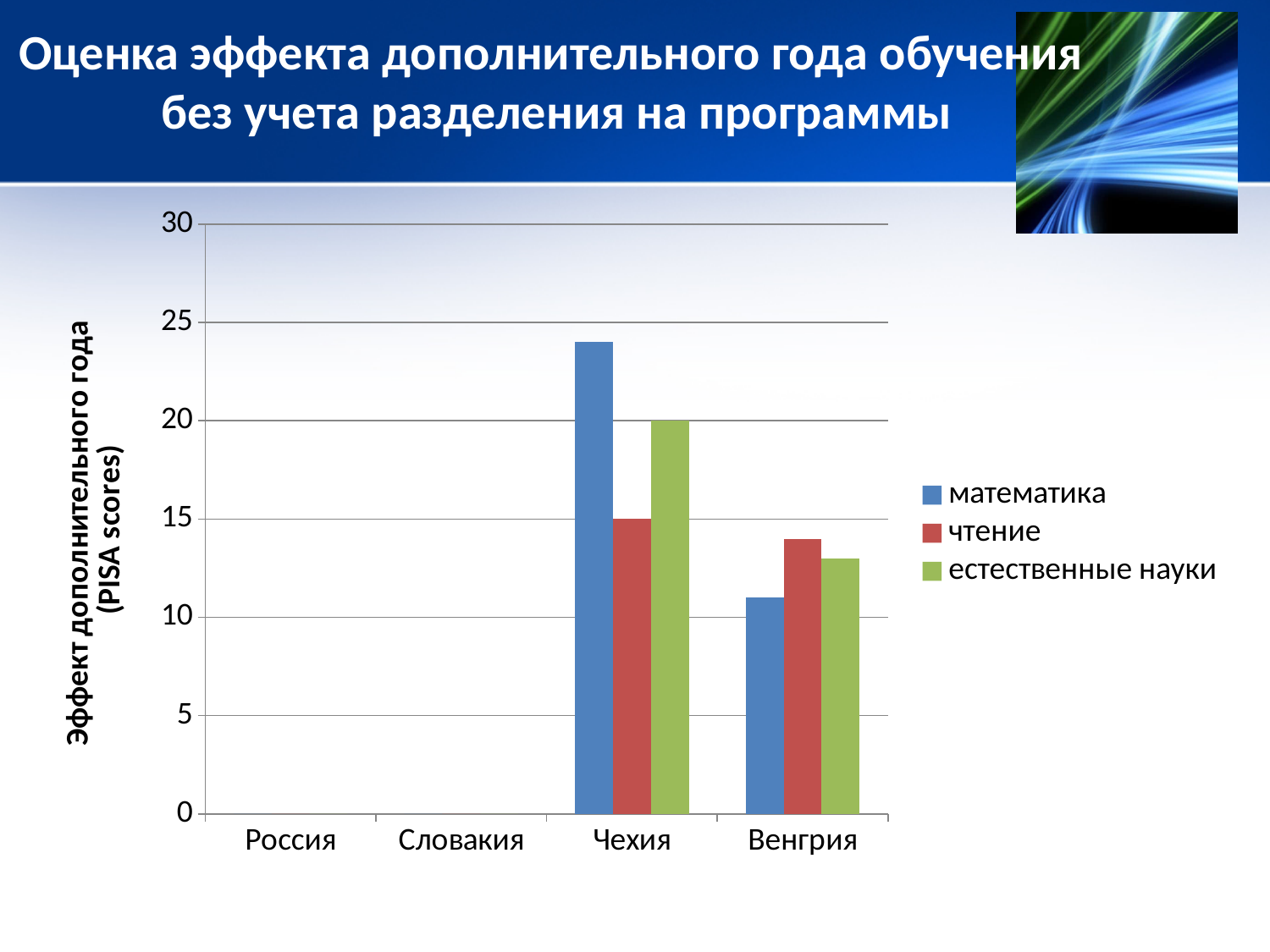
What is the value for естественные науки for Чехия? 20 What kind of chart is shown on the slide? bar chart Is the value for математика for Венгрия greater or less than 15? less What is the value for чтение for Чехия? 15 Which country has the larger value for естественные науки: Чехия or Венгрия? Чехия What are the three series listed in the legend? математика, чтение, естественные науки What is the difference between естественные науки and чтение for Чехия? 5 Which country has the highest value for математика? Чехия Which is larger for Венгрия: чтение or математика? чтение How many series does the legend list? 3 Is the value for математика for Чехия greater or less than 20? greater How many countries are shown on the x axis? 4